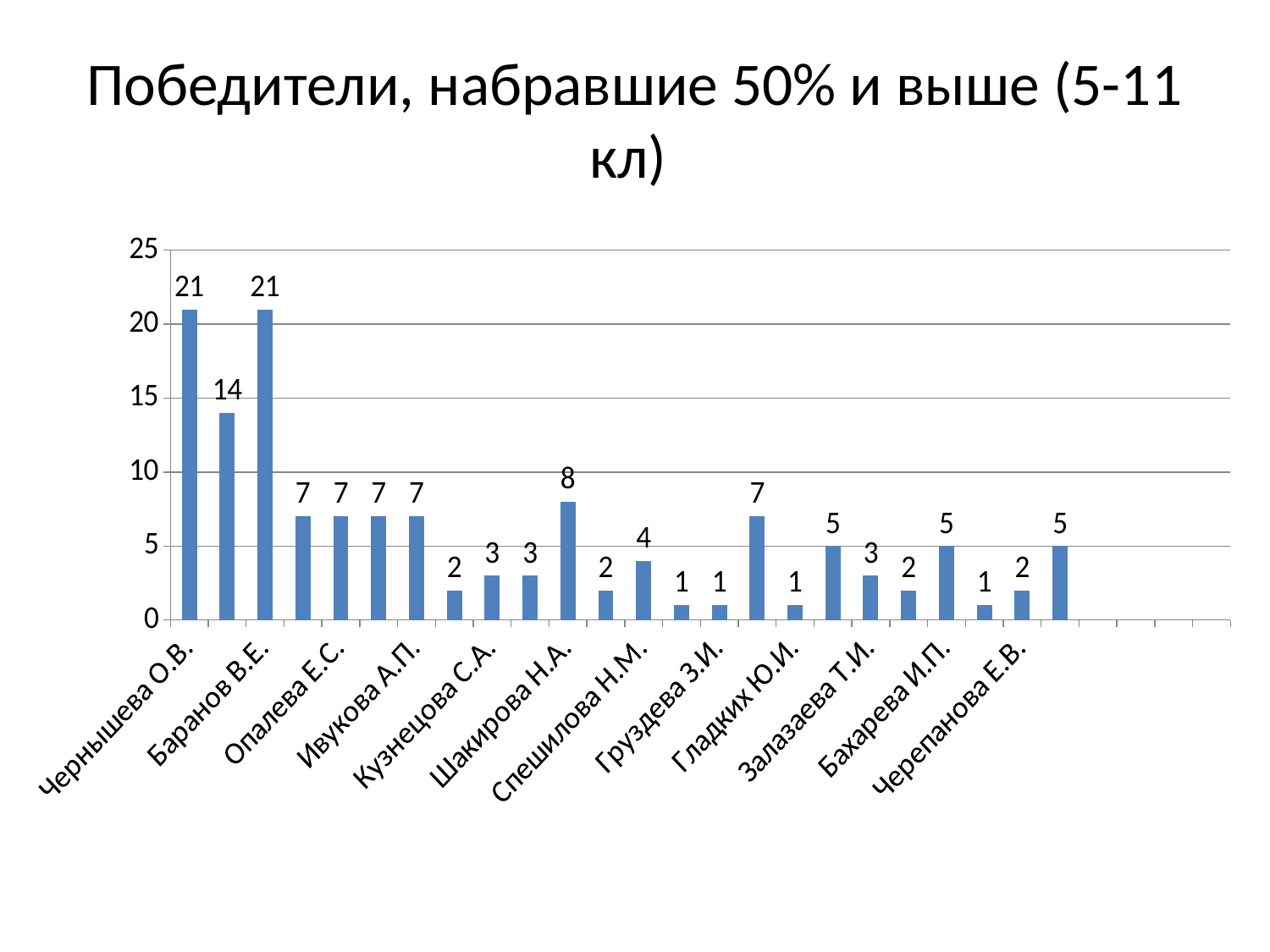
What is the value of the first bar, for Чернышева О.В.? 21 What is the highest value shown on the chart? 21 How many bars are plotted on the chart? 24 Which is larger, the value for Чернышева О.В. or the value for Шакирова Н.А.? Чернышева О.В. What is the lowest value shown on the chart? 1 What is the difference between the value for Чернышева О.В. and the value for Шакирова Н.А.? 13 What kind of chart is shown on the slide? bar chart What is the value shown for Баранов В.Е.? 21 What is the value shown for Шакирова Н.А.? 8 Is the value for Чернышева О.В. greater or less than 20? greater What is the title of the chart? Победители, набравшие 50% и выше (5-11 кл) How many category labels are printed along the x axis? 12